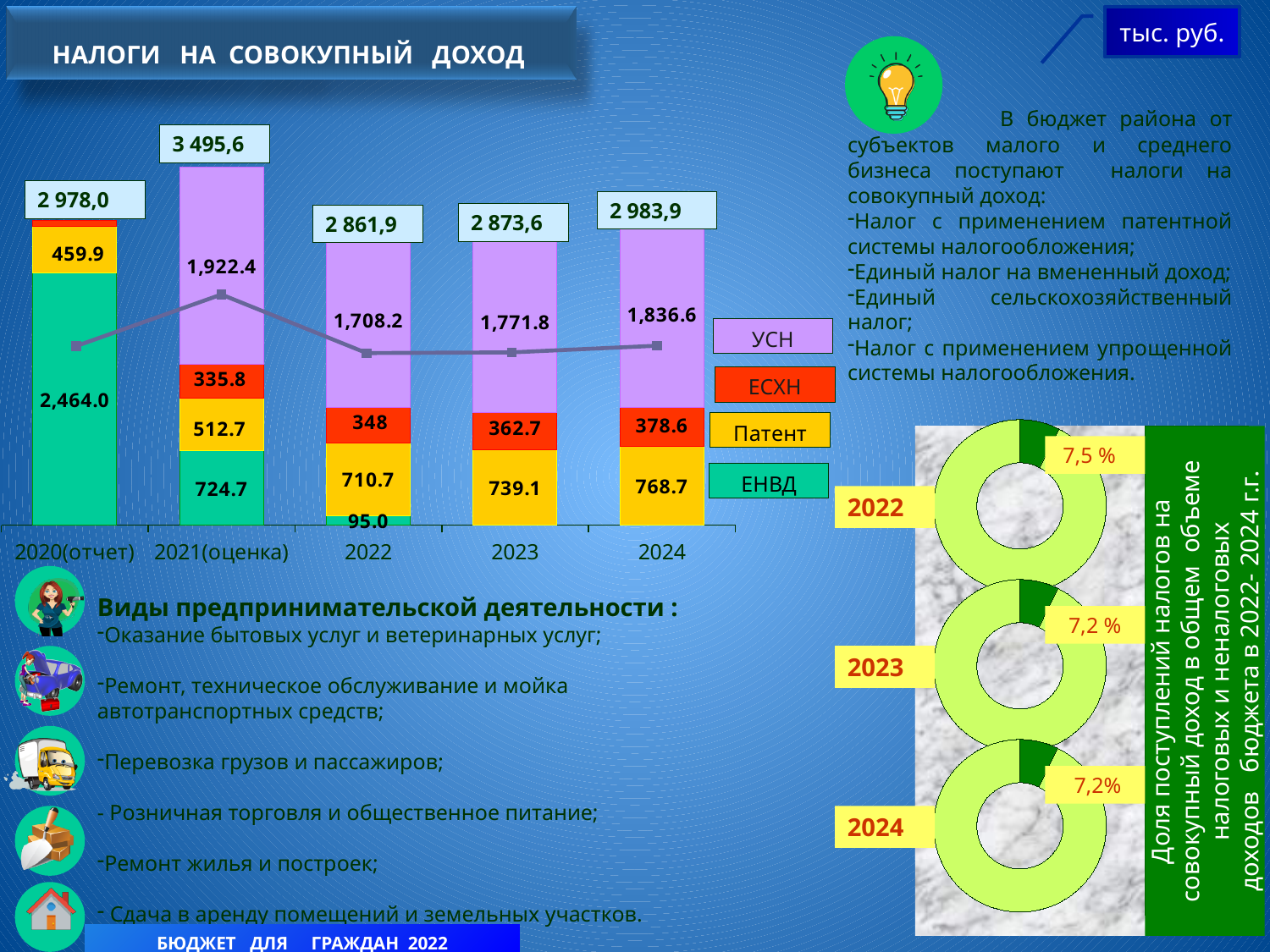
How many series does the legend of the stacked bar chart 'НАЛОГИ НА СОВОКУПНЫЙ ДОХОД' list? 4 On the stacked bar chart 'НАЛОГИ НА СОВОКУПНЫЙ ДОХОД', what is the ЕНВД value for 2020(отчет)? 2,464.0 How many year categories are shown on the x axis of the stacked bar chart 'НАЛОГИ НА СОВОКУПНЫЙ ДОХОД'? 5 On the donut charts on the right of the slide, what share is shown for 2022? 7,5 % On the stacked bar chart 'НАЛОГИ НА СОВОКУПНЫЙ ДОХОД', what is the ЕСХН value for 2023? 362.7 On the stacked bar chart 'НАЛОГИ НА СОВОКУПНЫЙ ДОХОД', what is the УСН value for 2024? 1,836.6 On the stacked bar chart 'НАЛОГИ НА СОВОКУПНЫЙ ДОХОД', what is the difference between the Патент values for 2024 and 2023? 29.6 On the stacked bar chart 'НАЛОГИ НА СОВОКУПНЫЙ ДОХОД', what is the Патент value for 2022? 710.7 On the stacked bar chart 'НАЛОГИ НА СОВОКУПНЫЙ ДОХОД', which is larger: the УСН value for 2021(оценка) or for 2022? 2021(оценка) On the stacked bar chart 'НАЛОГИ НА СОВОКУПНЫЙ ДОХОД', which year has the lowest total value? 2022 On the stacked bar chart 'НАЛОГИ НА СОВОКУПНЫЙ ДОХОД', what is the total value shown above the bar for 2021(оценка)? 3 495,6 On the stacked bar chart 'НАЛОГИ НА СОВОКУПНЫЙ ДОХОД', which year has the highest total value? 2021(оценка)